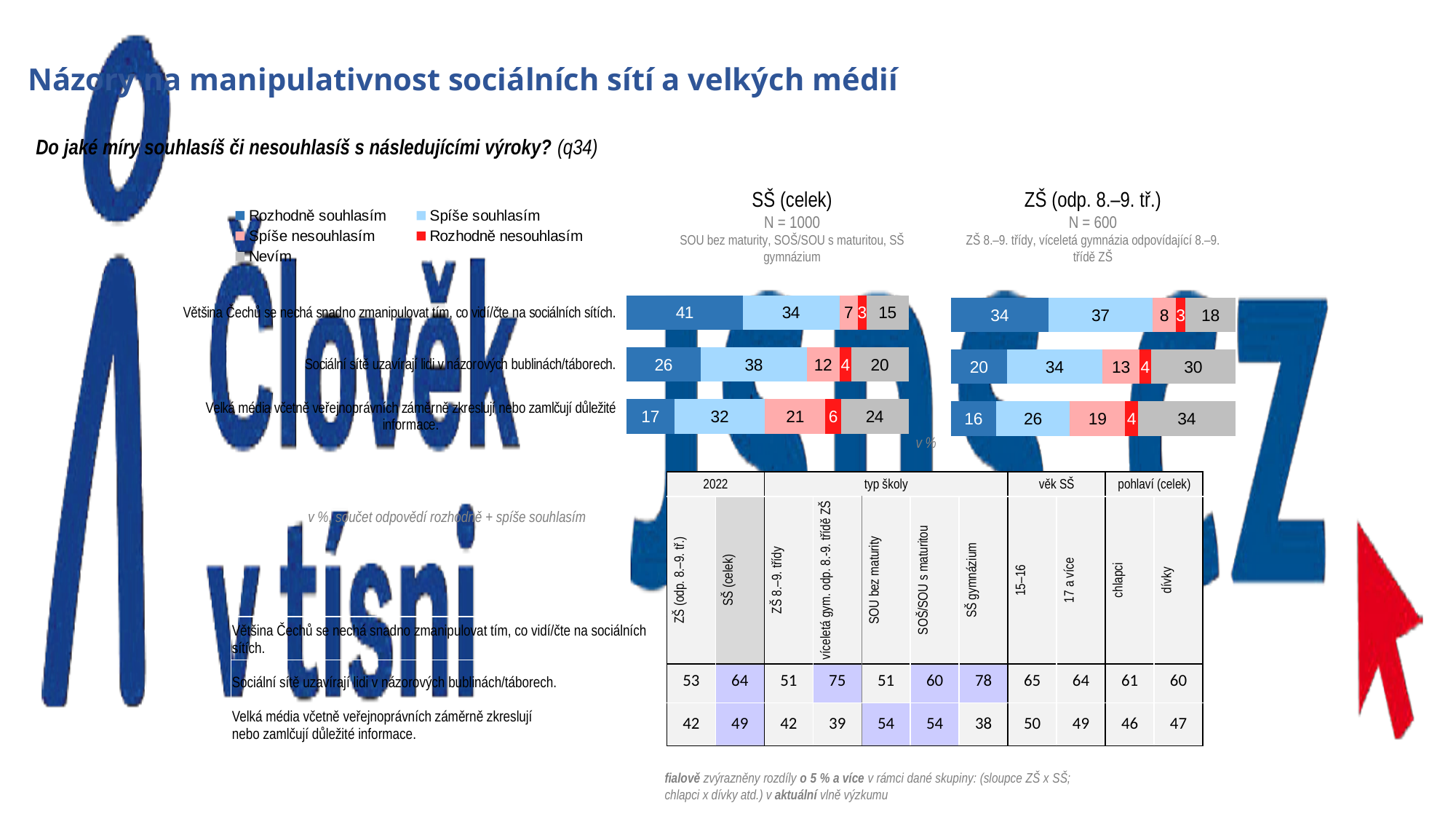
In the ZŠ (odp. 8.–9. tř.) chart, which is larger: the "Rozhodně souhlasím" value for "Sociální sítě uzavírají lidi v názorových bublinách/táborech." or for "Velká média včetně veřejnoprávních záměrně zkreslují nebo zamlčují důležité informace."? Sociální sítě uzavírají lidi v názorových bublinách/táborech. In the ZŠ (odp. 8.–9. tř.) chart, which statement has the lowest "Nevím" value? Většina Čechů se nechá snadno zmanipulovat tím, co vidí/čte na sociálních sítích. How many statements (categories) are plotted in the SŠ (celek) chart? 3 What kind of chart is the ZŠ (odp. 8.–9. tř.) chart? Stacked bar chart In the SŠ (celek) chart, which statement has the highest "Rozhodně souhlasím" value? Většina Čechů se nechá snadno zmanipulovat tím, co vidí/čte na sociálních sítích. In the SŠ (celek) chart, what is the difference between the "Nevím" values for "Velká média včetně veřejnoprávních záměrně zkreslují nebo zamlčují důležité informace." and "Většina Čechů se nechá snadno zmanipulovat tím, co vidí/čte na sociálních sítích."? 9 In the SŠ (celek) chart, what is the value of "Spíše nesouhlasím" for the statement "Sociální sítě uzavírají lidi v názorových bublinách/táborech."? 12 In the SŠ (celek) chart, what is the value of "Rozhodně souhlasím" for the statement "Většina Čechů se nechá snadno zmanipulovat tím, co vidí/čte na sociálních sítích."? 41 What is the sample size (N) shown for the SŠ (celek) chart? N = 1000 In the ZŠ (odp. 8.–9. tř.) chart, what is the value of "Spíše souhlasím" for the statement "Většina Čechů se nechá snadno zmanipulovat tím, co vidí/čte na sociálních sítích."? 37 In the ZŠ (odp. 8.–9. tř.) chart, what is the value of "Nevím" for the statement "Velká média včetně veřejnoprávních záměrně zkreslují nebo zamlčují důležité informace."? 34 How many series does the legend of the stacked bar charts list? 5